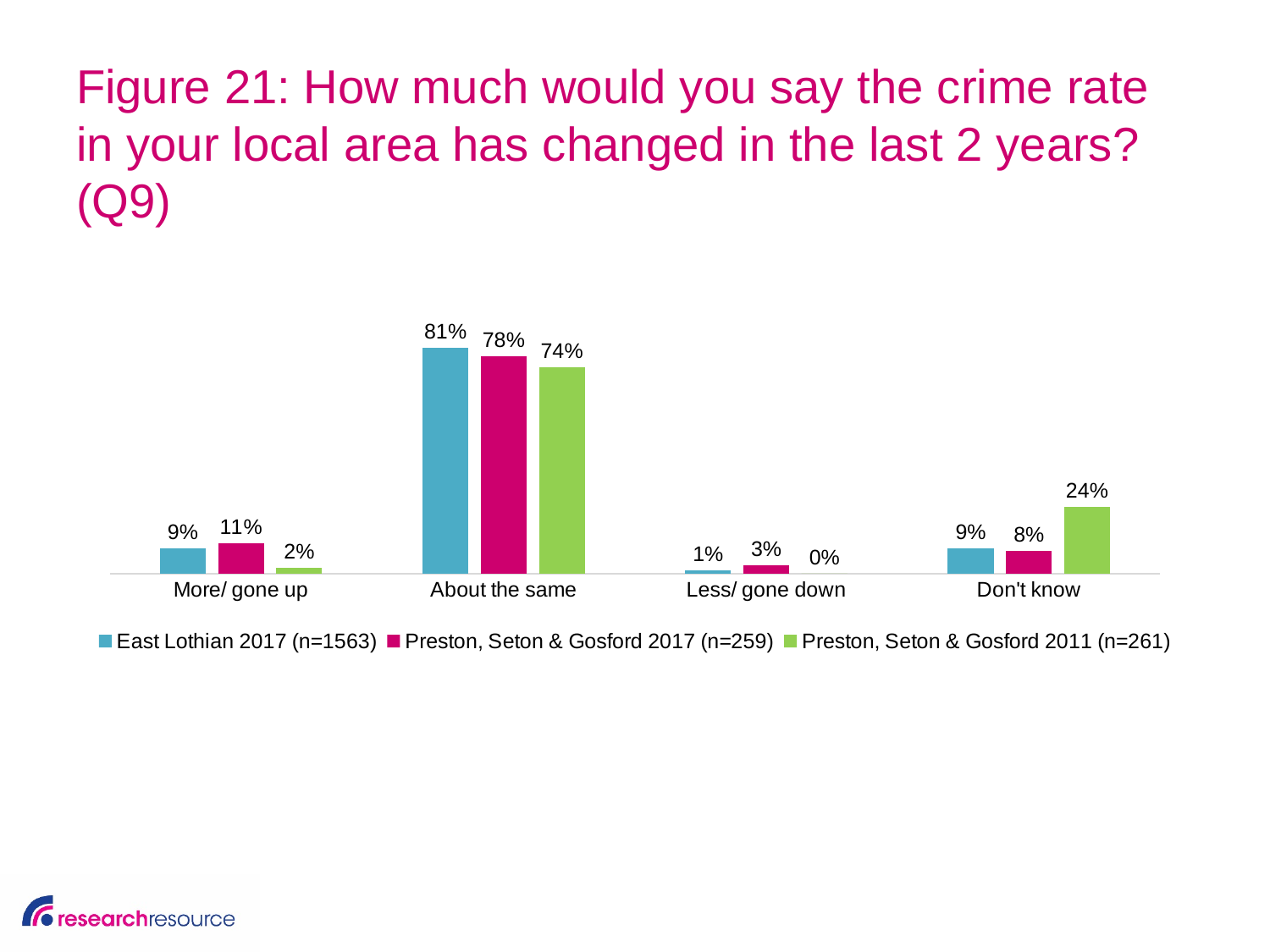
Which category has the highest value for the Preston, Seton & Gosford 2011 series? About the same What is the value for Preston, Seton & Gosford 2011 in the 'Less/ gone down' category? 0% How many series does the legend list? 3 What percentage of East Lothian 2017 respondents said the crime rate was 'About the same'? 81% Which category has the lowest value for the East Lothian 2017 series? Less/ gone down In the 'Don't know' category, which series has the larger value: East Lothian 2017 or Preston, Seton & Gosford 2011? Preston, Seton & Gosford 2011 What is the sample size (n) for the Preston, Seton & Gosford 2017 series shown in the legend? 259 How many response categories are shown on the x axis? 4 What is the value for Preston, Seton & Gosford 2011 in the 'Don't know' category? 24% What kind of chart is shown on the slide? Bar chart What is the value for Preston, Seton & Gosford 2017 in the 'More/ gone up' category? 11% What is the difference between the East Lothian 2017 and Preston, Seton & Gosford 2011 values for 'About the same'? 7%